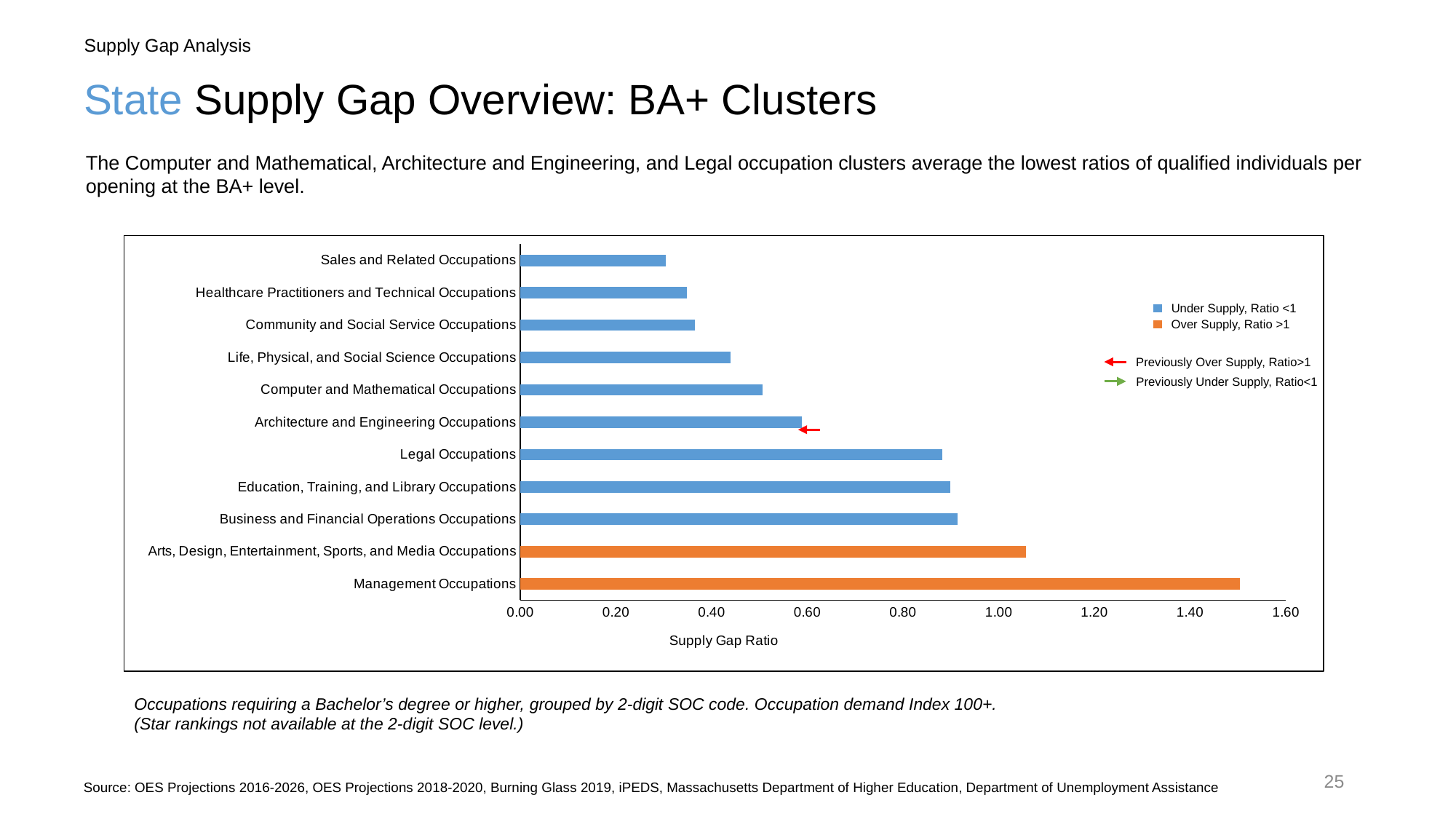
How many occupation clusters are plotted in the chart? 11 Is the supply gap ratio for Management Occupations greater or less than 1.40? greater What kind of chart is shown on the slide? bar chart Is the supply gap ratio for Arts, Design, Entertainment, Sports, and Media Occupations greater or less than 1.00? greater Which occupation cluster has the highest supply gap ratio? Management Occupations Is the supply gap ratio for Architecture and Engineering Occupations greater or less than 0.80? less Which has a larger supply gap ratio: Management Occupations or Arts, Design, Entertainment, Sports, and Media Occupations? Management Occupations What is the title of the horizontal axis of the chart? Supply Gap Ratio How many bar series does the chart legend list? 2 Which occupation cluster has the lowest supply gap ratio? Sales and Related Occupations